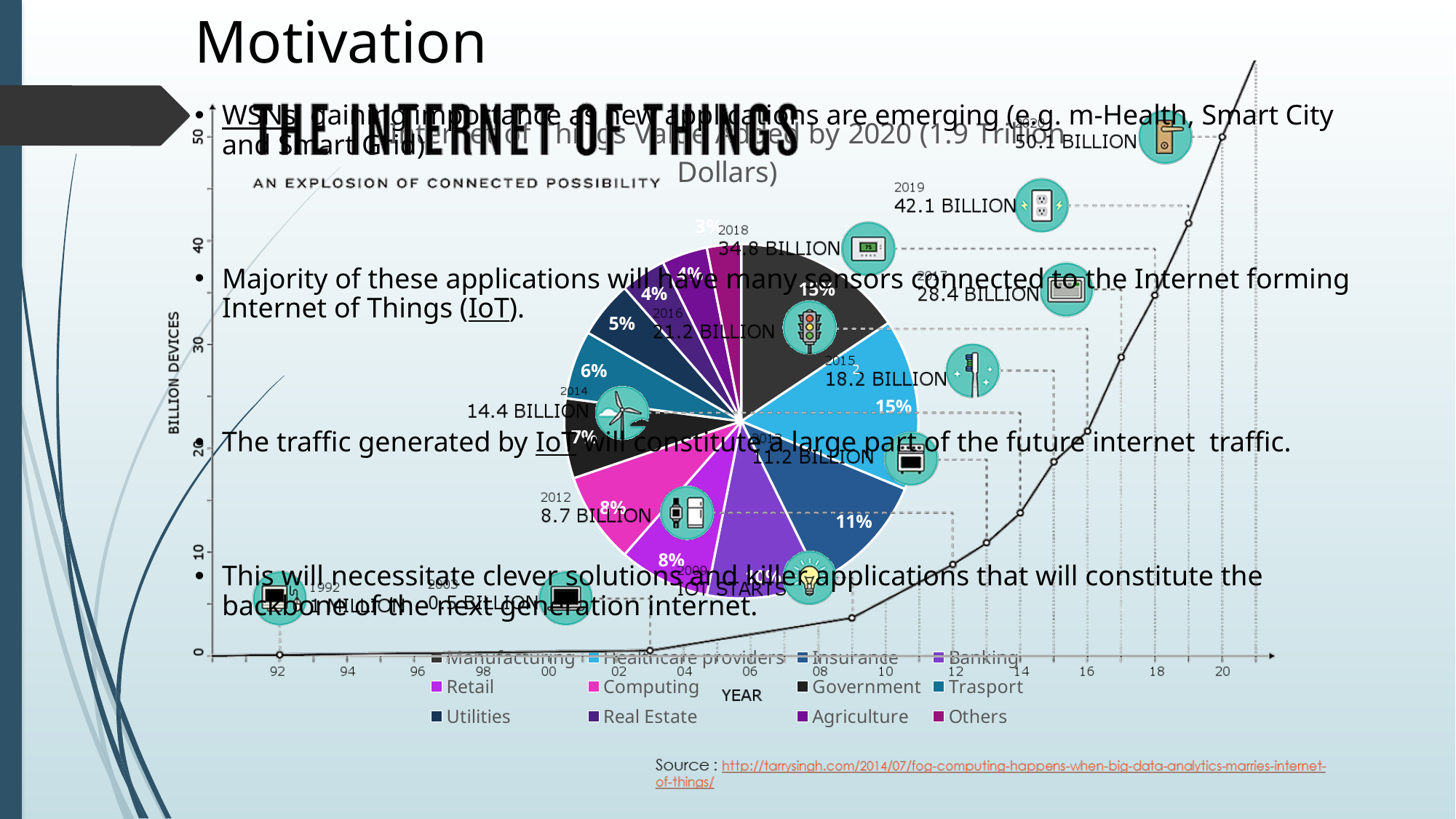
In the pie chart 'Internet of Things Value Added by 2020', what share is labelled for Others? 3% In the pie chart 'Internet of Things Value Added by 2020', what is the difference between the Insurance share and the Trasport share? 5% In the pie chart 'Internet of Things Value Added by 2020', what share is labelled for Government? 7% In the pie chart 'Internet of Things Value Added by 2020', what share is labelled for Insurance? 11% What kind of chart is the 'Internet of Things Value Added by 2020' chart? Pie chart In the line chart 'The Internet of Things', how many billion devices are labelled for 2020? 50.1 BILLION In the line chart 'The Internet of Things', how many billion devices are labelled for 2015? 18.2 BILLION In the pie chart 'Internet of Things Value Added by 2020', which is larger, the share for Computing or the share for Utilities? Computing In the pie chart 'Internet of Things Value Added by 2020', how many categories does the legend list? 12 In the pie chart 'Internet of Things Value Added by 2020', what share is labelled for Healthcare providers? 15% In the pie chart 'Internet of Things Value Added by 2020', which category has the smallest share? Others In the line chart 'The Internet of Things', do the values rise or fall as the year increases? Rise